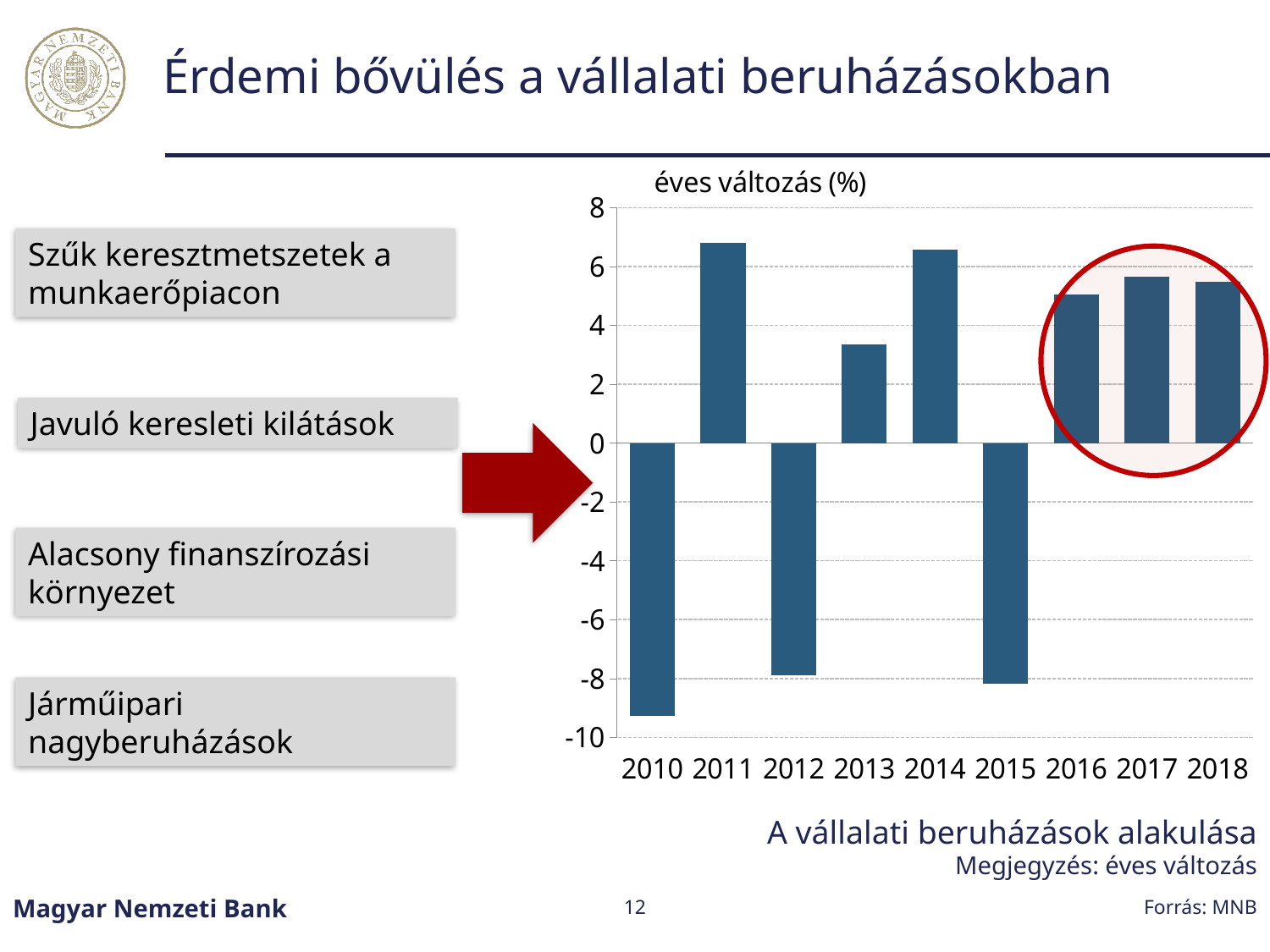
Is the value for 2016 greater or less than 4? greater Which is larger, the value for 2015 or the value for 2016? 2016 Which is larger, the value for 2013 or the value for 2014? 2014 Is the value for 2013 greater or less than 2? greater How many years are shown on the x axis of the chart? 9 Is the value for 2012 greater or less than -6? less What is the title of the chart given below it? A vállalati beruházások alakulása What kind of chart is shown on the slide? bar chart Which year has the lowest value in the chart? 2010 What is the label shown above the y axis of the chart? éves változás (%)